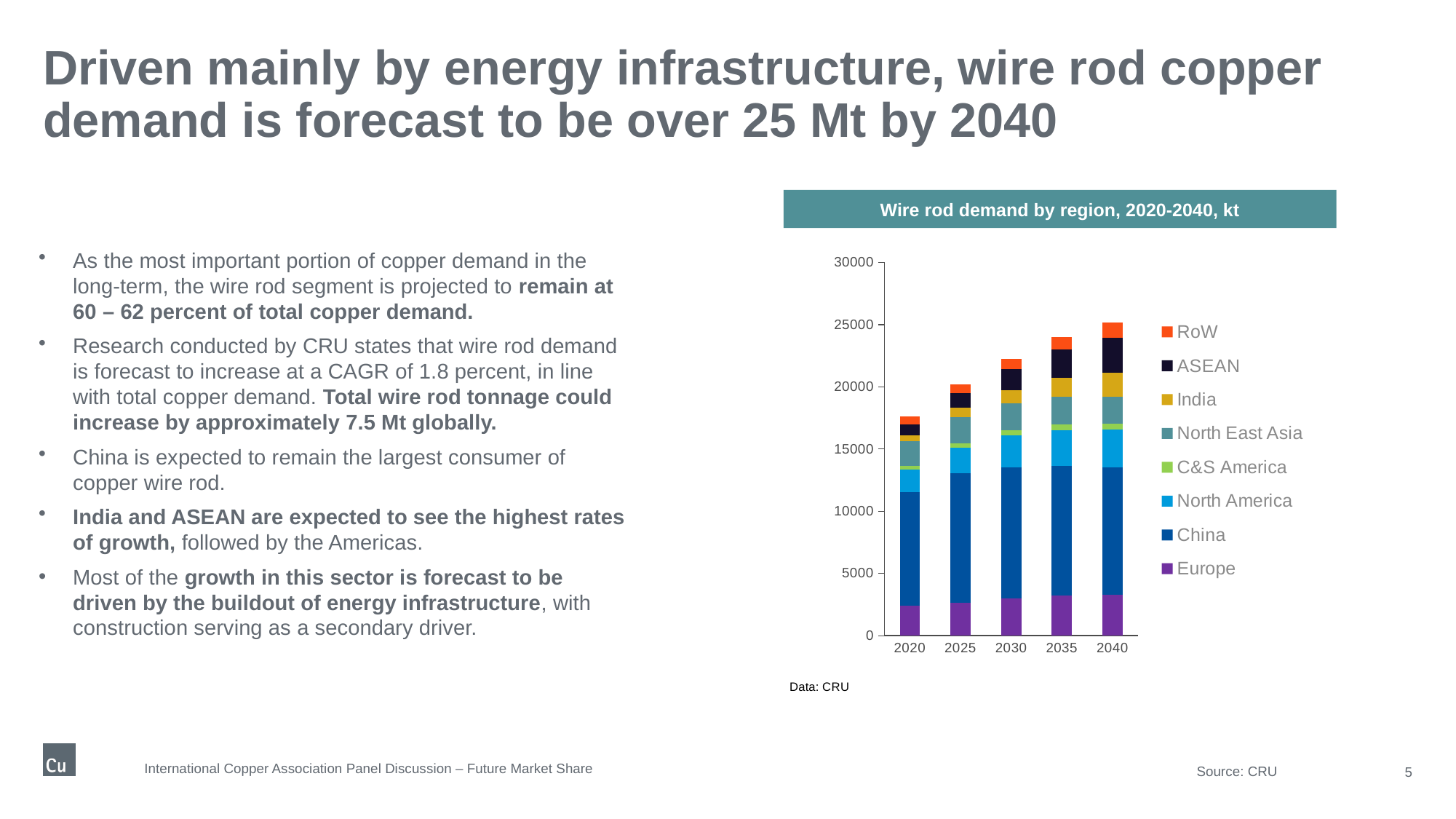
Is the total wire rod demand for 2030 greater or less than 20000? greater How many years (bars) are shown on the x axis of the chart? 5 Which year has the lowest total wire rod demand in the chart? 2020 Is the total wire rod demand for 2020 greater or less than 20000? less Which region forms the largest segment of each bar in the chart? China Do the total bar heights rise or fall from 2020 to 2040? Rise How many series does the chart legend list? 8 Which series is listed at the bottom of the chart legend? Europe Is the total wire rod demand for 2035 greater or less than 25000? less What kind of chart is shown on the slide? Stacked bar chart Which year has the highest total wire rod demand in the chart? 2040 What is the title of the chart? Wire rod demand by region, 2020-2040, kt